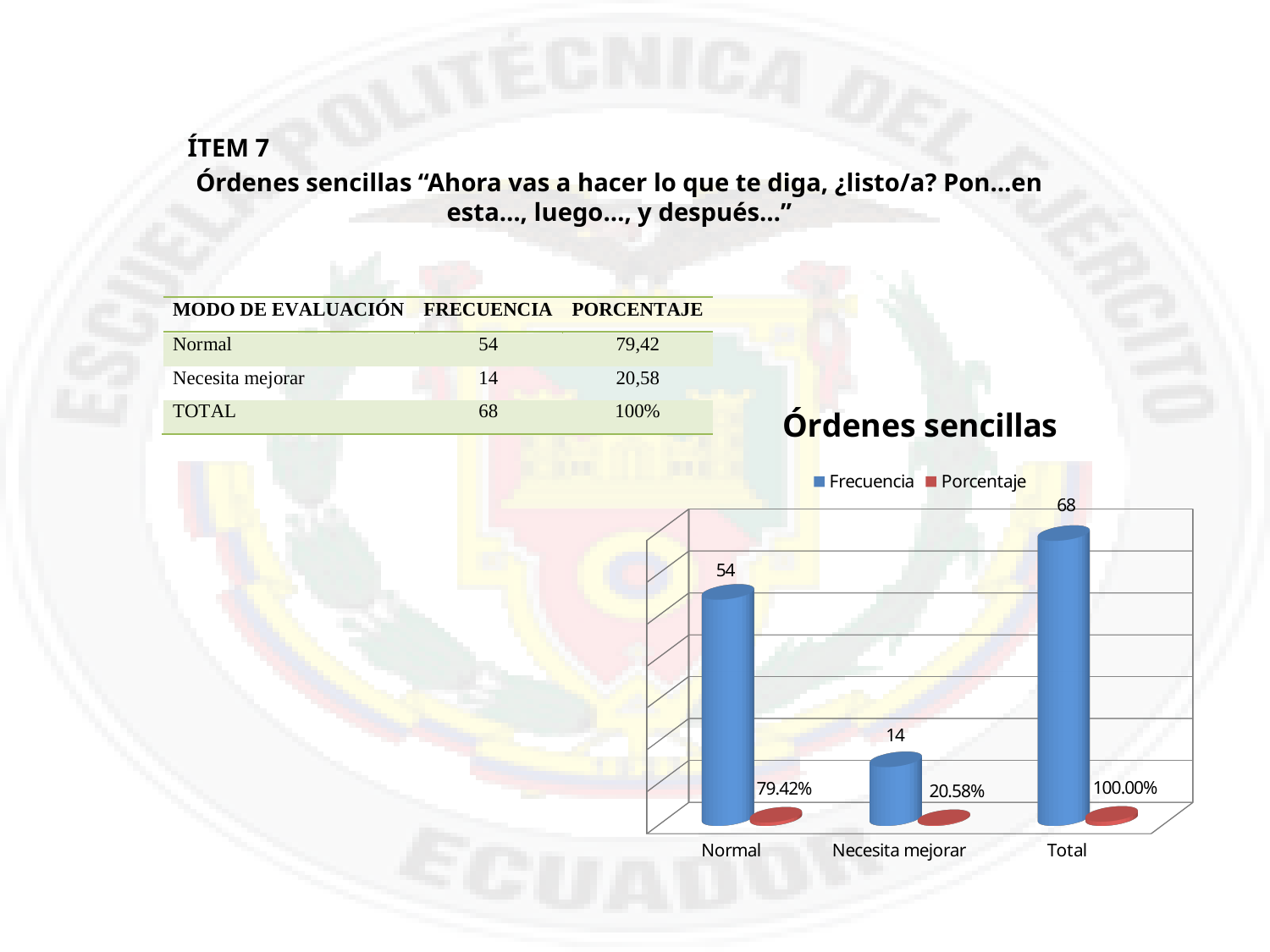
How many series does the chart legend list? 2 What is the Frecuencia value for Normal in the chart? 54 Which category has the lowest Frecuencia value? Necesita mejorar Which category has the highest Frecuencia value? Total What is the title of the chart? Órdenes sencillas What is the Porcentaje value for Necesita mejorar in the chart? 20.58% What is the Frecuencia value for Total in the chart? 68 What is the Frecuencia value for Necesita mejorar in the chart? 14 How many categories are shown on the x axis of the chart? 3 What is the difference between the Frecuencia values for Normal and Necesita mejorar? 40 Which is larger, the Frecuencia value for Normal or for Necesita mejorar? Normal What is the Porcentaje value for Normal in the chart? 79.42%